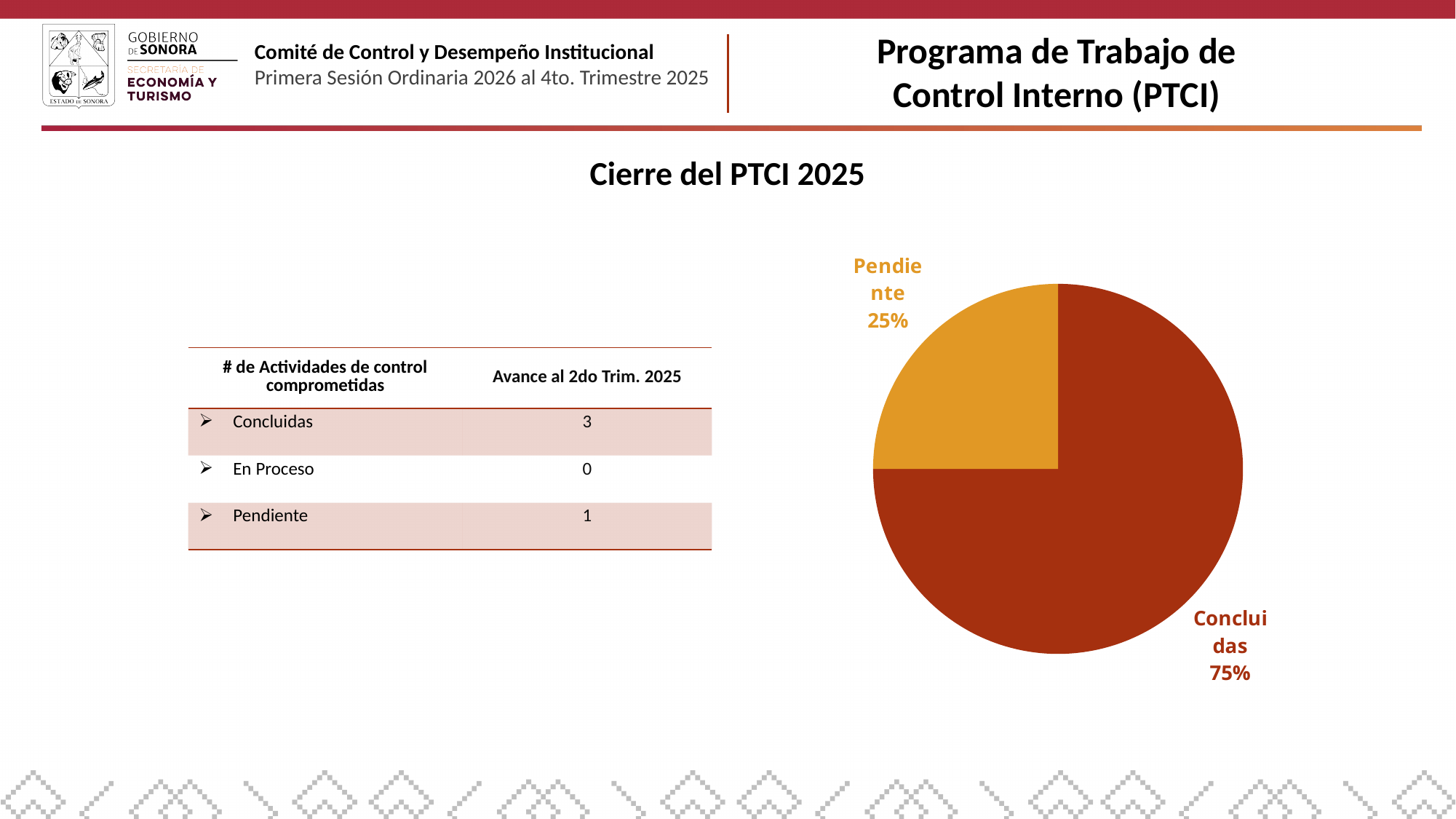
Which is larger in the pie chart, Concluidas or Pendiente? Concluidas Which slice of the pie chart is the largest? Concluidas Is the share for Concluidas greater or less than 50%? greater Which slice of the pie chart is the smallest? Pendiente What colour is the Concluidas slice of the pie chart? dark red What share of the pie chart is labelled Concluidas? 75% What colour is the Pendiente slice of the pie chart? orange What kind of chart is shown on the slide? pie chart How many slices does the pie chart have? 2 What is the difference in percentage points between the Concluidas and Pendiente slices? 50% What share of the pie chart is labelled Pendiente? 25%